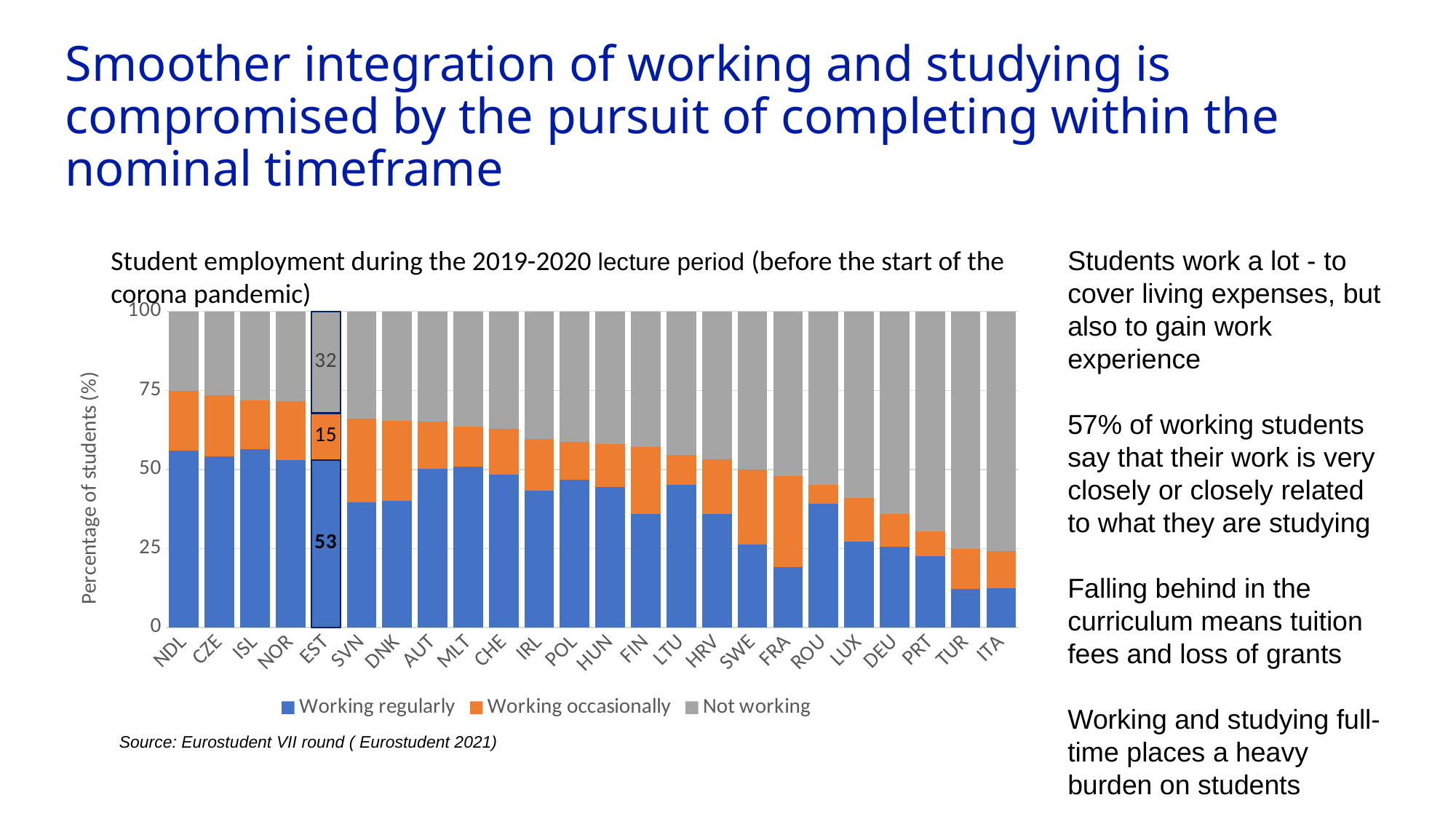
How many series does the legend list? 3 What is the difference between the Working regularly and Not working values for EST? 21 What is the value for Working regularly for EST? 53 What kind of chart is shown on the slide? Stacked bar chart What is the value for Working occasionally for EST? 15 What is the value for Not working for EST? 32 Which country has the larger Working regularly value, NDL or ITA? NDL What is the total of the EST stacked bar? 100 How many countries are shown on the x axis? 24 Is the Working regularly value for ITA greater or less than 25? less Is the Working regularly value for NDL greater or less than 50? greater What is the label of the y axis? Percentage of students (%)